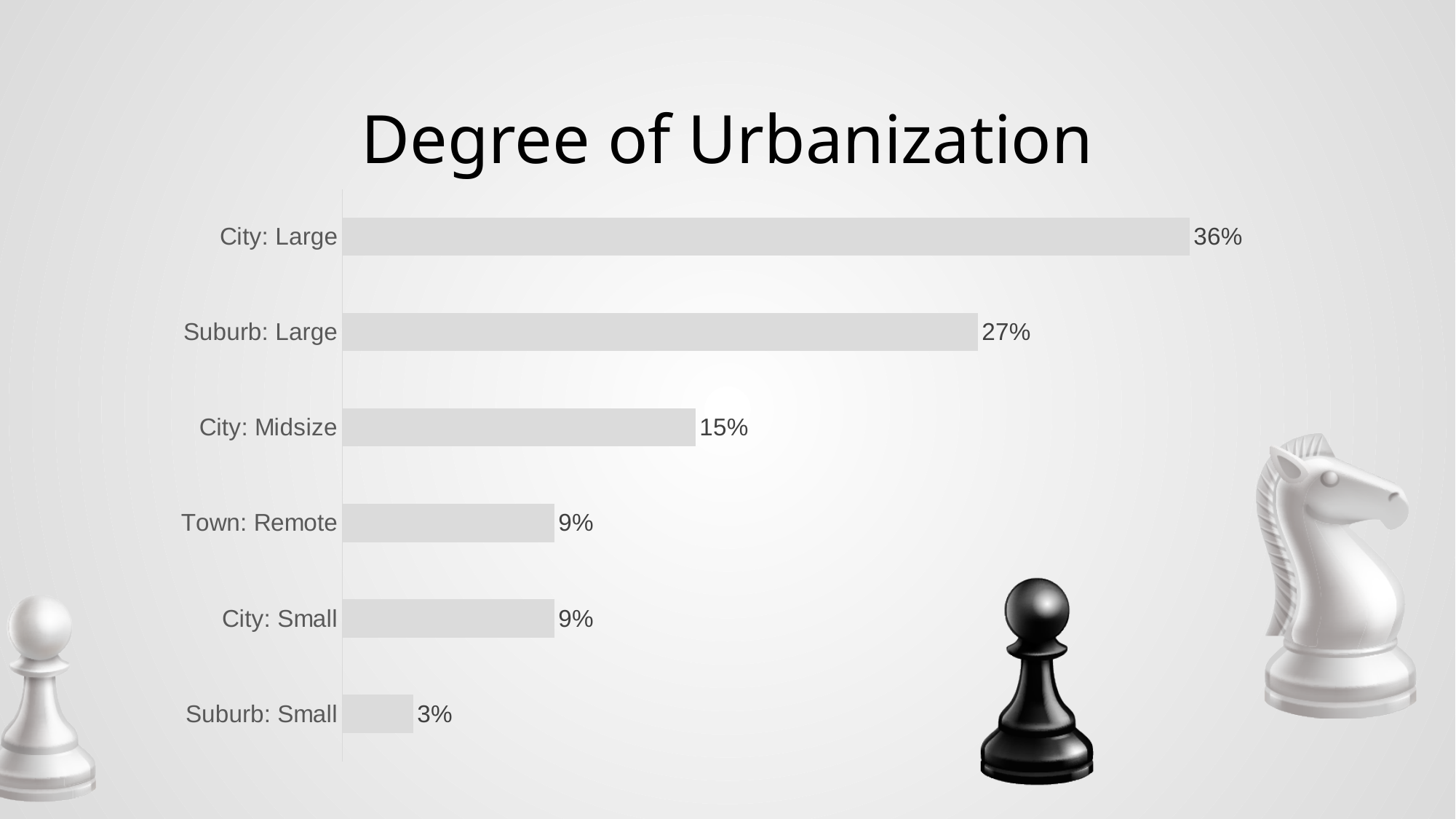
What kind of chart is shown on the slide? Bar chart What is the value for Suburb: Small? 3% What is the difference between the values for City: Midsize and Suburb: Small? 12% How many categories are shown in the chart? 6 What is the value for City: Midsize? 15% What is the title of the chart? Degree of Urbanization What is the value for Suburb: Large? 27% What is the difference between the values for City: Large and Suburb: Large? 9% Which is larger, the value for Suburb: Large or the value for City: Midsize? Suburb: Large Which category has the lowest value? Suburb: Small What is the value for City: Large? 36% Which category has the highest value? City: Large